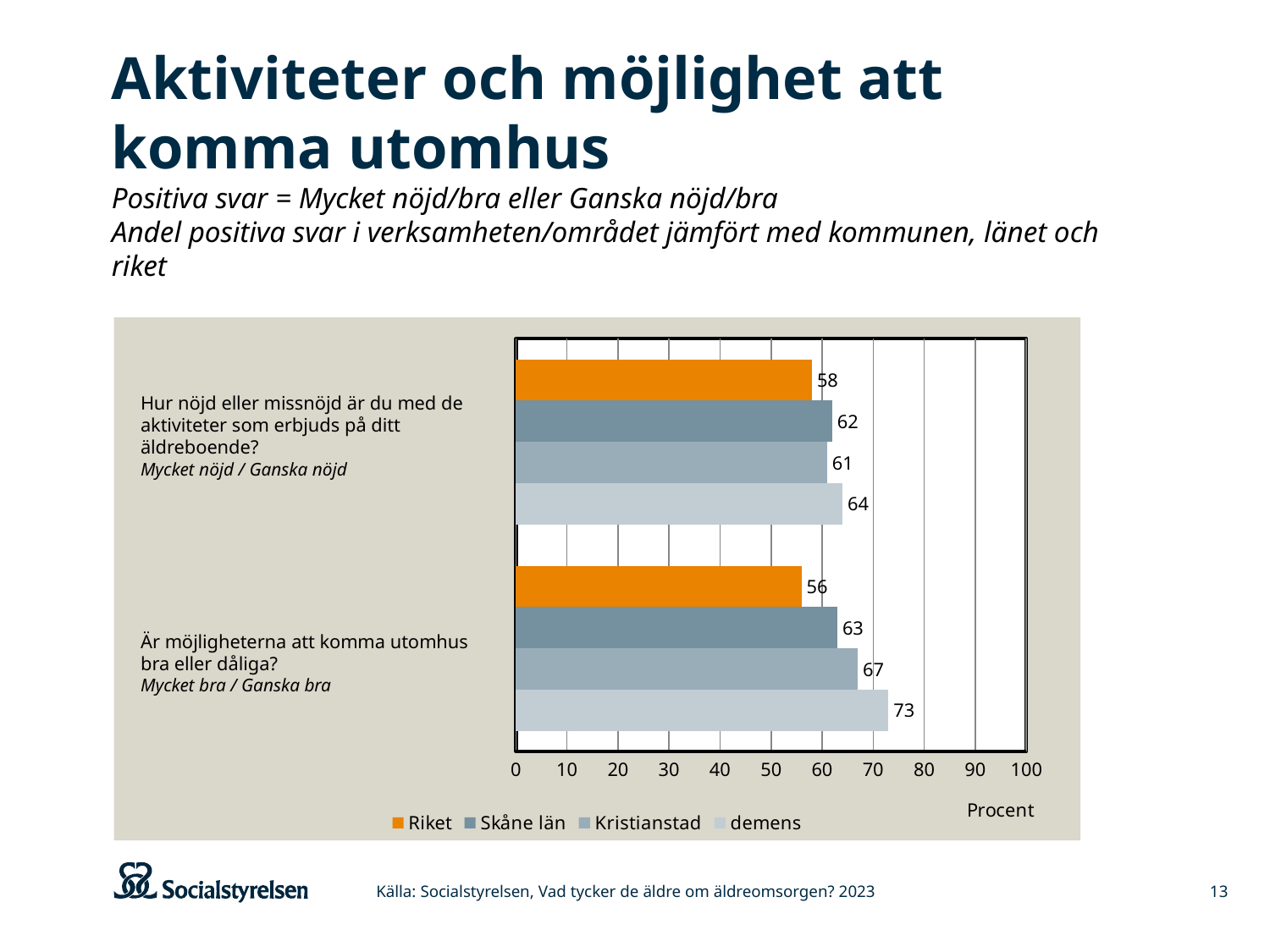
How many series does the legend list? 4 What is the difference between the demens value and the Riket value for the question about opportunities to get outdoors? 17 How many survey questions (categories) are shown on the chart? 2 What is the value for Skåne län for the question about activities offered at the care home? 62 Which series has the lowest value for the question about activities offered at the care home? Riket Which series has the highest value for the question about opportunities to get outdoors? demens What unit is shown on the x axis of the chart? Procent Which is larger for the question about activities offered at the care home: the value for Skåne län or the value for Kristianstad? Skåne län What is the value for Kristianstad for the question about opportunities to get outdoors? 67 What is the value for demens for the question about opportunities to get outdoors ("Är möjligheterna att komma utomhus bra eller dåliga?")? 73 What is the value for Riket for the question about activities offered at the care home ("Hur nöjd eller missnöjd är du med de aktiviteter som erbjuds på ditt äldreboende?")? 58 What kind of chart is shown on the slide? bar chart